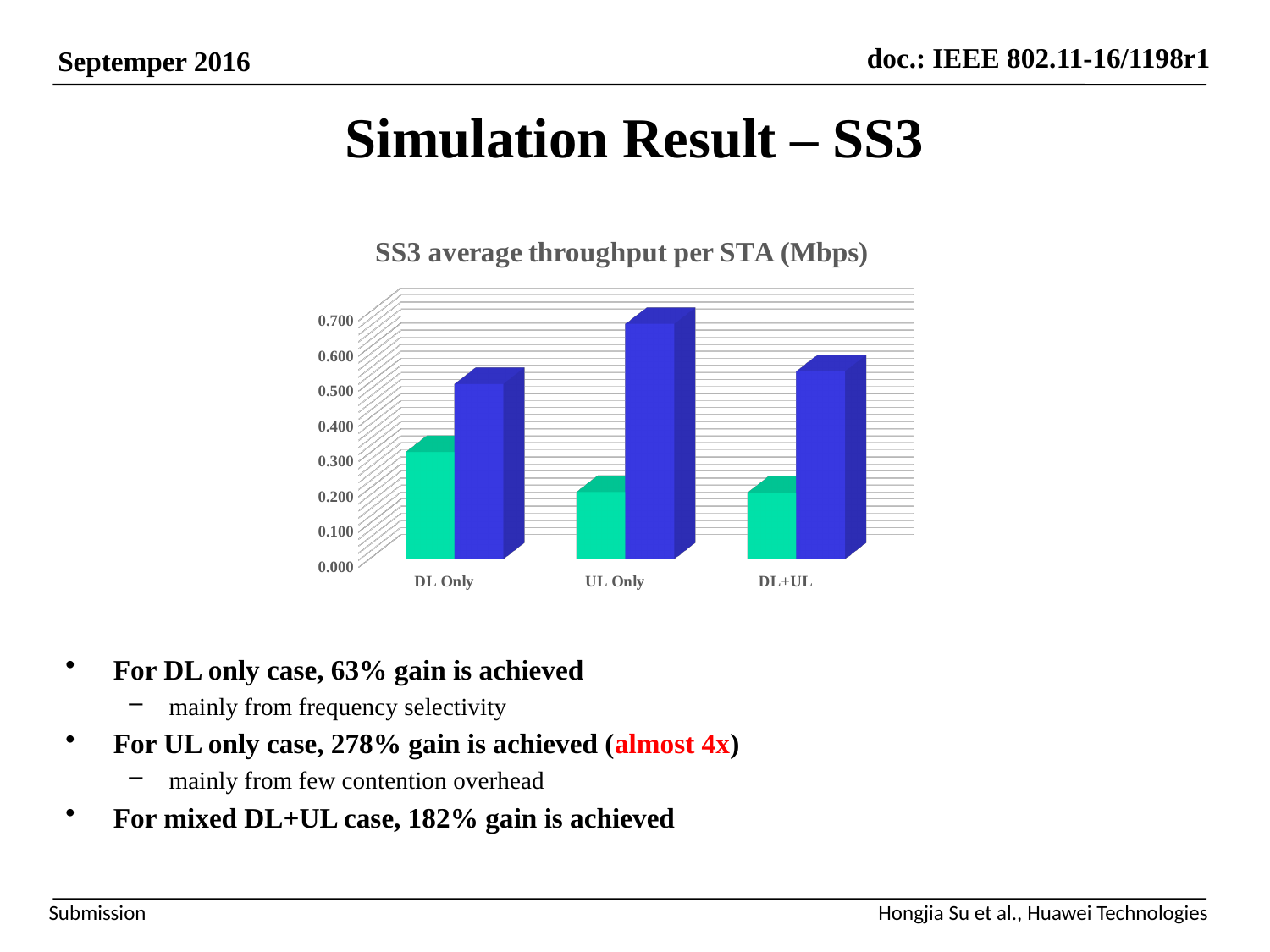
Is the blue bar for UL Only greater or less than 0.600? greater Which category has the tallest blue bar? UL Only Which category has the tallest green bar? DL Only Is the green bar for UL Only greater or less than 0.300? less What is the title of the chart? SS3 average throughput per STA (Mbps) Which is larger, the green bar for DL Only or the green bar for UL Only? DL Only What kind of chart is shown on the slide? bar chart Is the green bar for DL Only greater or less than 0.400? less Which is larger, the blue bar for DL Only or the blue bar for UL Only? UL Only How many categories are shown on the x axis of the chart? 3 How many bars are plotted for each category in the chart? 2